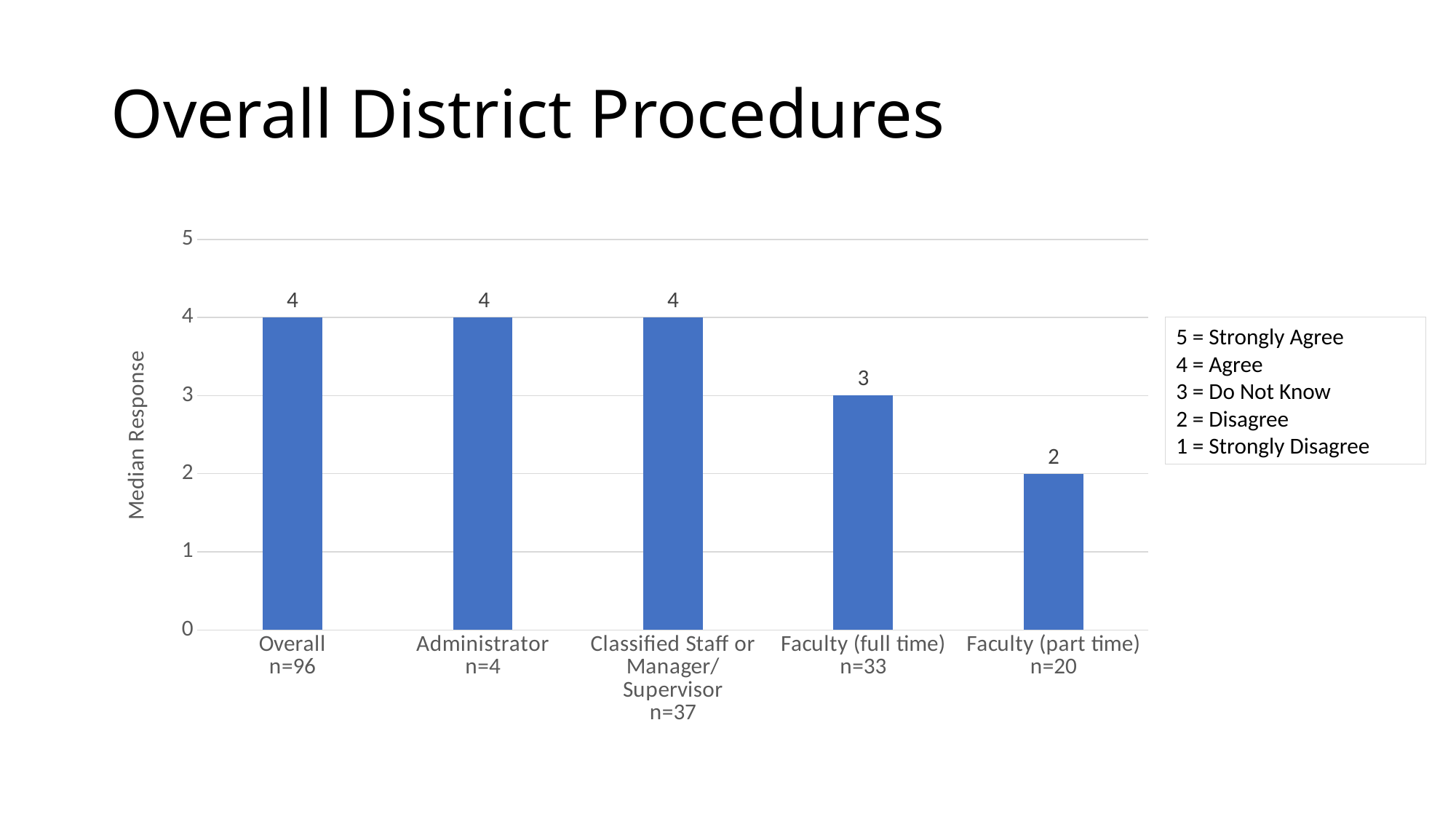
What kind of chart is shown on the slide? Bar chart Which category has the lowest median response? Faculty (part time) Do the median response values rise or fall from left to right across the categories? Fall What is the median response for Overall (n=96)? 4 What is the label of the y axis? Median Response Which is larger, the median response for Faculty (full time) or Faculty (part time)? Faculty (full time) What is the difference between the median response for Administrator and Faculty (part time)? 2 What is the median response for Classified Staff or Manager/Supervisor? 4 According to the key on the slide, what does a response of 3 mean? Do Not Know What is the median response for Faculty (full time)? 3 How many categories are shown on the x axis? 5 What is the median response for Faculty (part time)? 2